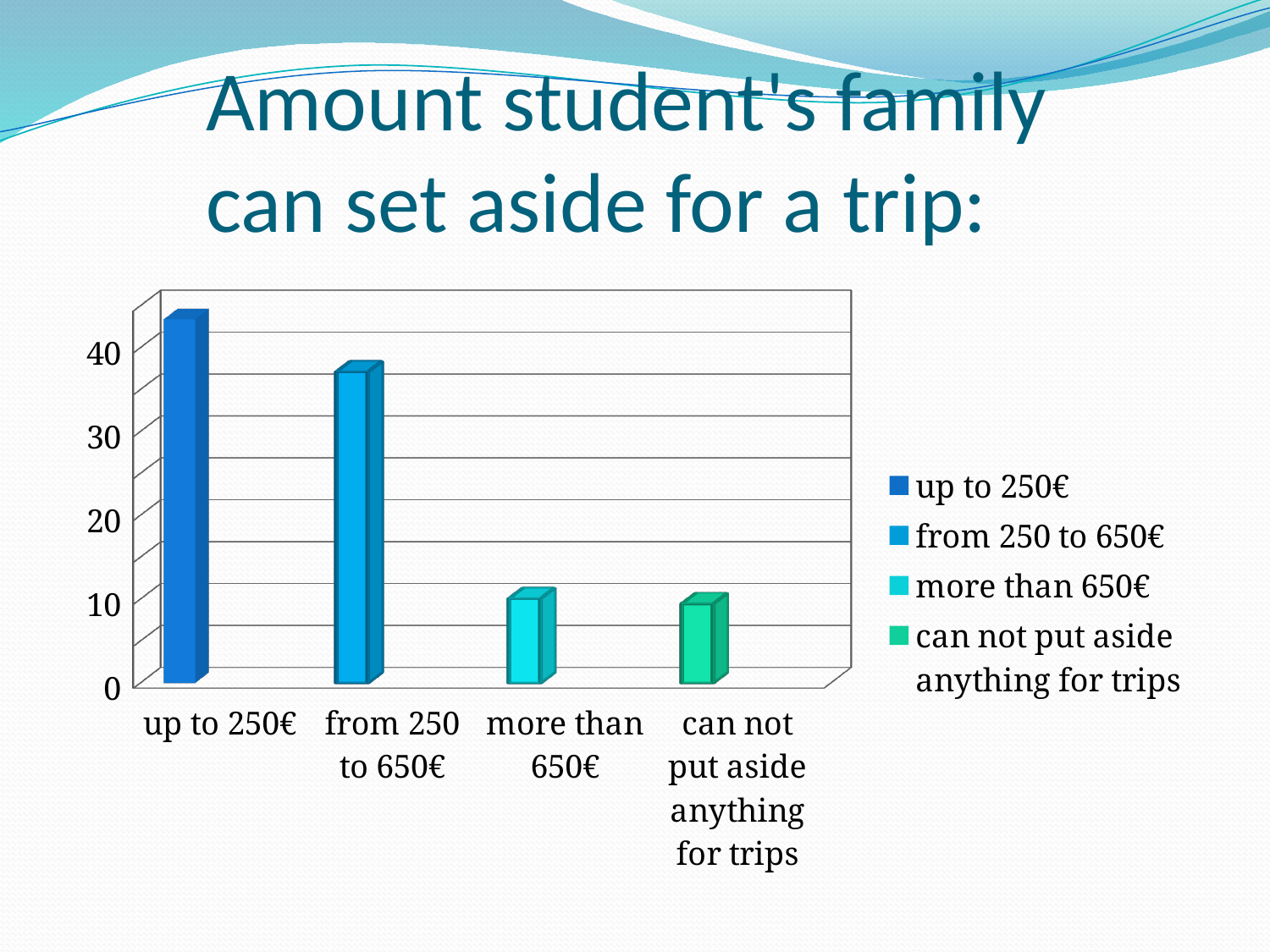
Is the value for 'more than 650€' greater or less than 20? less Which category has the highest value? up to 250€ Is the value for 'from 250 to 650€' greater or less than 30? greater Is the value for 'up to 250€' greater or less than 40? greater Which is larger, the value for 'up to 250€' or the value for 'from 250 to 650€'? up to 250€ What kind of chart is shown on the slide? bar chart How many entries does the legend list? 4 What is the last entry listed in the chart's legend? can not put aside anything for trips How many categories are plotted in the chart? 4 Which is larger, the value for 'from 250 to 650€' or the value for 'more than 650€'? from 250 to 650€ What is the title of the chart on the slide? Amount student's family can set aside for a trip: